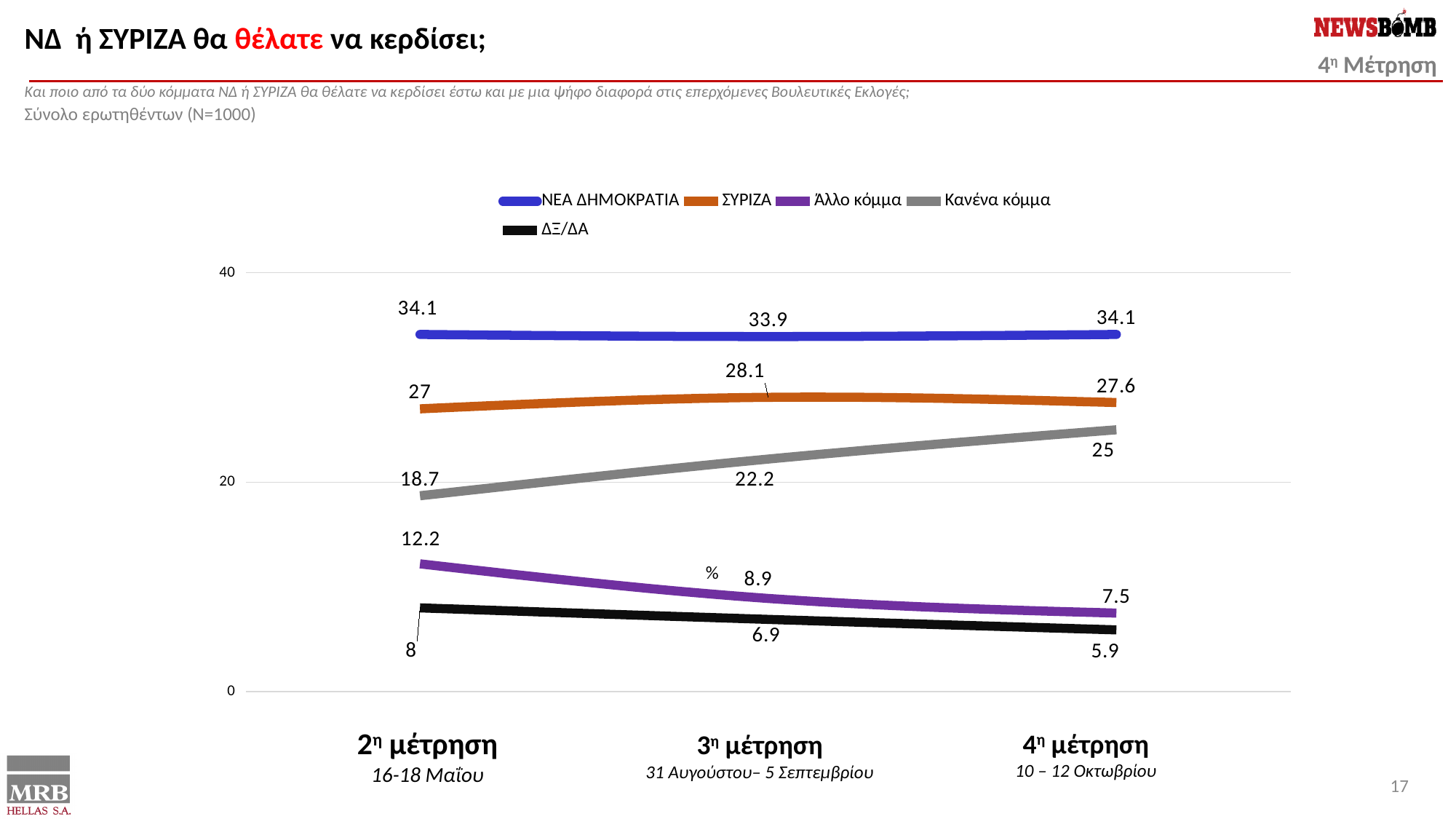
What is the difference between ΝΕΑ ΔΗΜΟΚΡΑΤΙΑ and ΣΥΡΙΖΑ at the 2η μέτρηση? 7.1 What is the value for ΔΞ/ΔΑ at the 3η μέτρηση? 6.9 Which is larger at the 3η μέτρηση, Άλλο κόμμα or ΔΞ/ΔΑ? Άλλο κόμμα Does the value for Κανένα κόμμα rise or fall from the 2η μέτρηση to the 4η μέτρηση? rise What kind of chart is shown on the slide? line chart Which series has the highest value at the 4η μέτρηση? ΝΕΑ ΔΗΜΟΚΡΑΤΙΑ What is the value for Κανένα κόμμα at the 2η μέτρηση? 18.7 How many measurement points are plotted along the x axis? 3 Which series has the lowest value at the 2η μέτρηση? ΔΞ/ΔΑ What is the value for ΣΥΡΙΖΑ at the 4η μέτρηση? 27.6 How many series does the legend list? 5 What is the value for ΝΕΑ ΔΗΜΟΚΡΑΤΙΑ at the 3η μέτρηση? 33.9